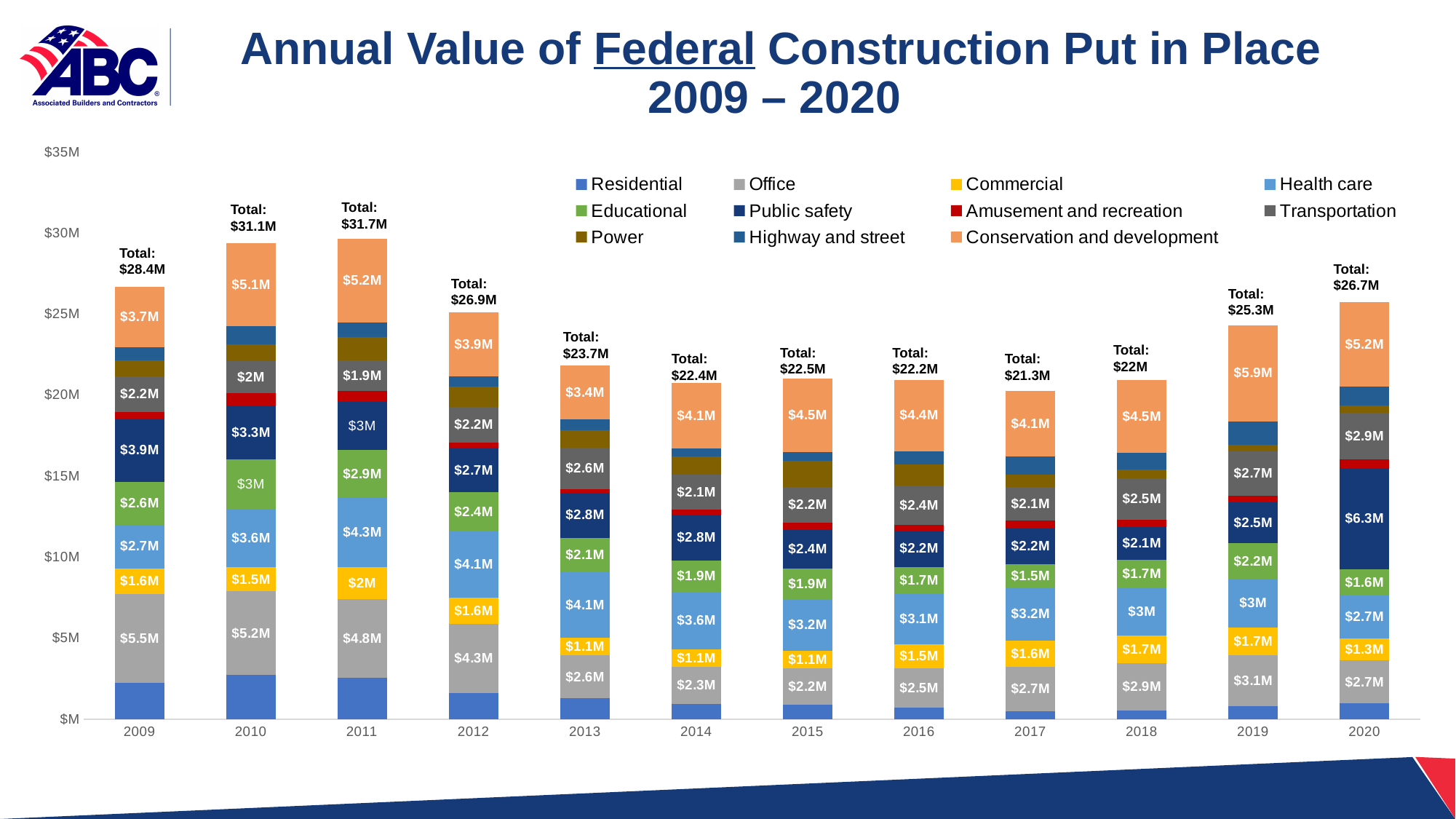
How many years are shown along the x axis? 12 Which year has the highest total value of federal construction put in place? 2011 Is the total value for 2009 greater or less than $25M? greater Which year has the lowest total value of federal construction put in place? 2017 How many series does the legend list? 11 What is the total value of federal construction put in place for 2011? $31.7M What kind of chart is shown on the slide? Stacked bar chart What is the value for Conservation and development in 2019? $5.9M What is the value for Office in 2009? $5.5M What is the difference between the total for 2010 and the total for 2009? $2.7M What is the value for Public safety in 2020? $6.3M Which is larger, the Health care value in 2011 or the Health care value in 2020? 2011